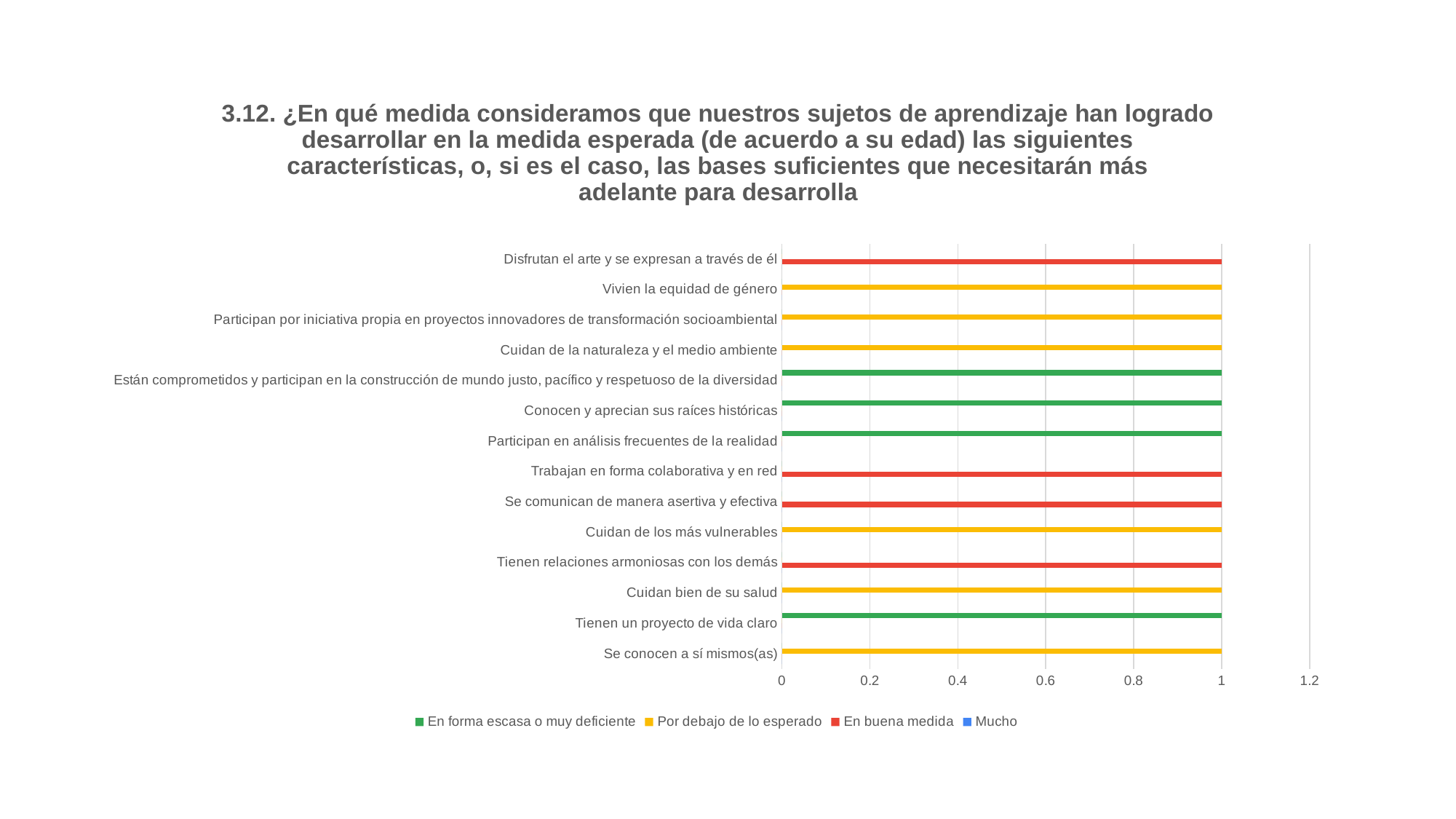
What is the value of the bar for "Tienen un proyecto de vida claro"? 1 Is the value for "Cuidan bien de su salud" greater or less than 0.8? greater How many series does the legend list? 4 How many categories have a bar in the "En forma escasa o muy deficiente" series? 4 What kind of chart is shown on the slide? bar chart Is the value for "Conocen y aprecian sus raíces históricas" greater or less than 1.2? less Which series does the bar for "Vivien la equidad de género" belong to? Por debajo de lo esperado Which series does the bar for "Trabajan en forma colaborativa y en red" belong to? En buena medida How many categories are plotted on the chart? 14 What is the value of the bar for "Se conocen a sí mismos(as)"? 1 How many categories have a bar in the "Mucho" series? 0 What is the value of the bar for "Disfrutan el arte y se expresan a través de él"? 1